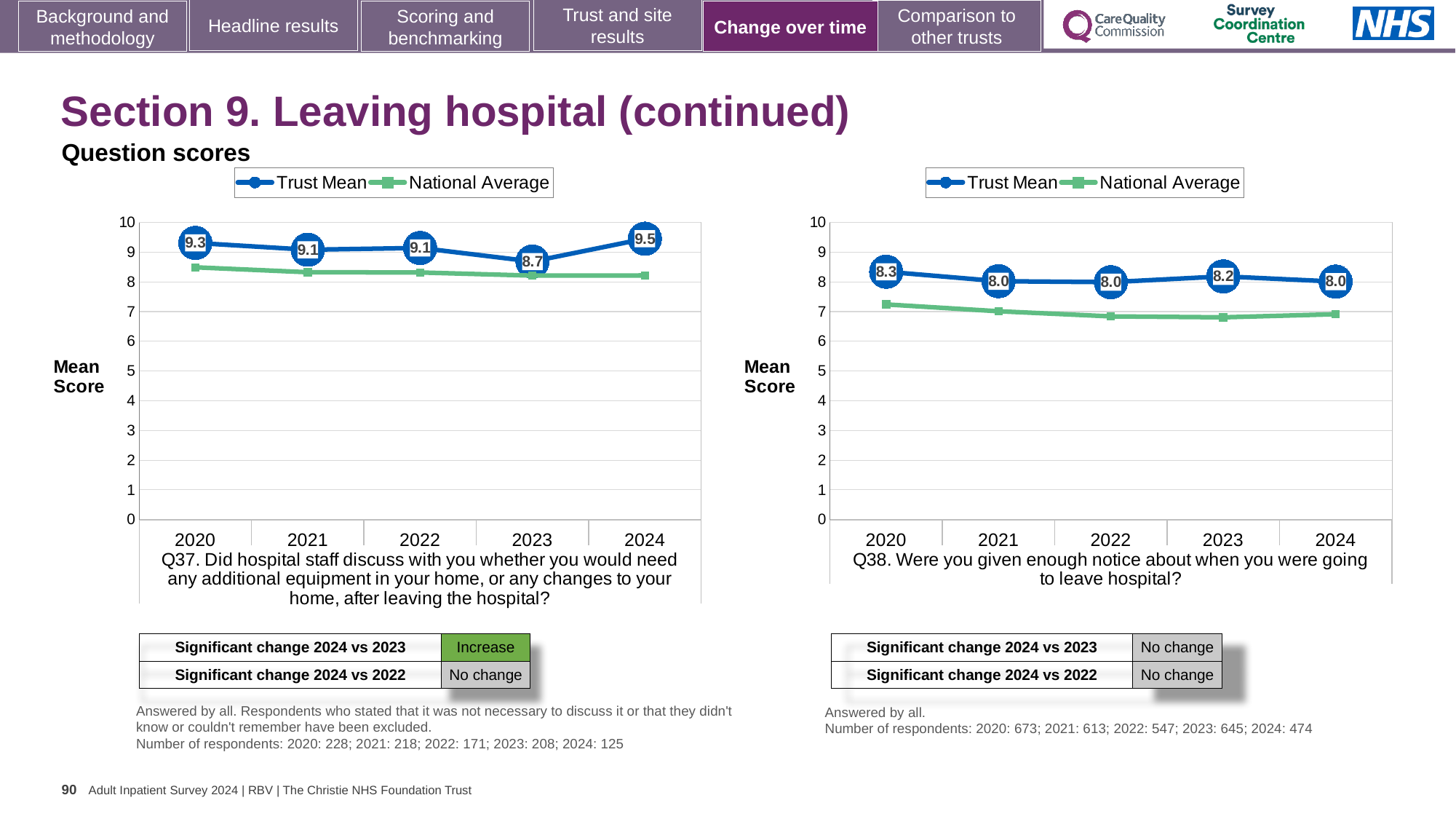
On the Q37 chart (left), is the National Average for 2024 greater or less than 9? less On the Q37 chart (left), what is the Trust Mean score for 2023? 8.7 On the Q38 chart (right), is the National Average for 2022 greater or less than 7? less On the Q37 chart (left), which year has the lowest Trust Mean score? 2023 On the Q38 chart (right), what is the Trust Mean score for 2020? 8.3 On the Q37 chart (left), which year has the highest Trust Mean score? 2024 How many series does the legend of the Q38 chart (right) list? 2 On the Q37 chart (left), what is the Trust Mean score for 2024? 9.5 What type of chart is the Q37 chart (left)? Line chart On the Q37 chart (left), what is the difference between the Trust Mean scores for 2024 and 2023? 0.8 On the Q38 chart (right), which year has the highest Trust Mean score? 2020 On the Q38 chart (right), what is the Trust Mean score for 2023? 8.2